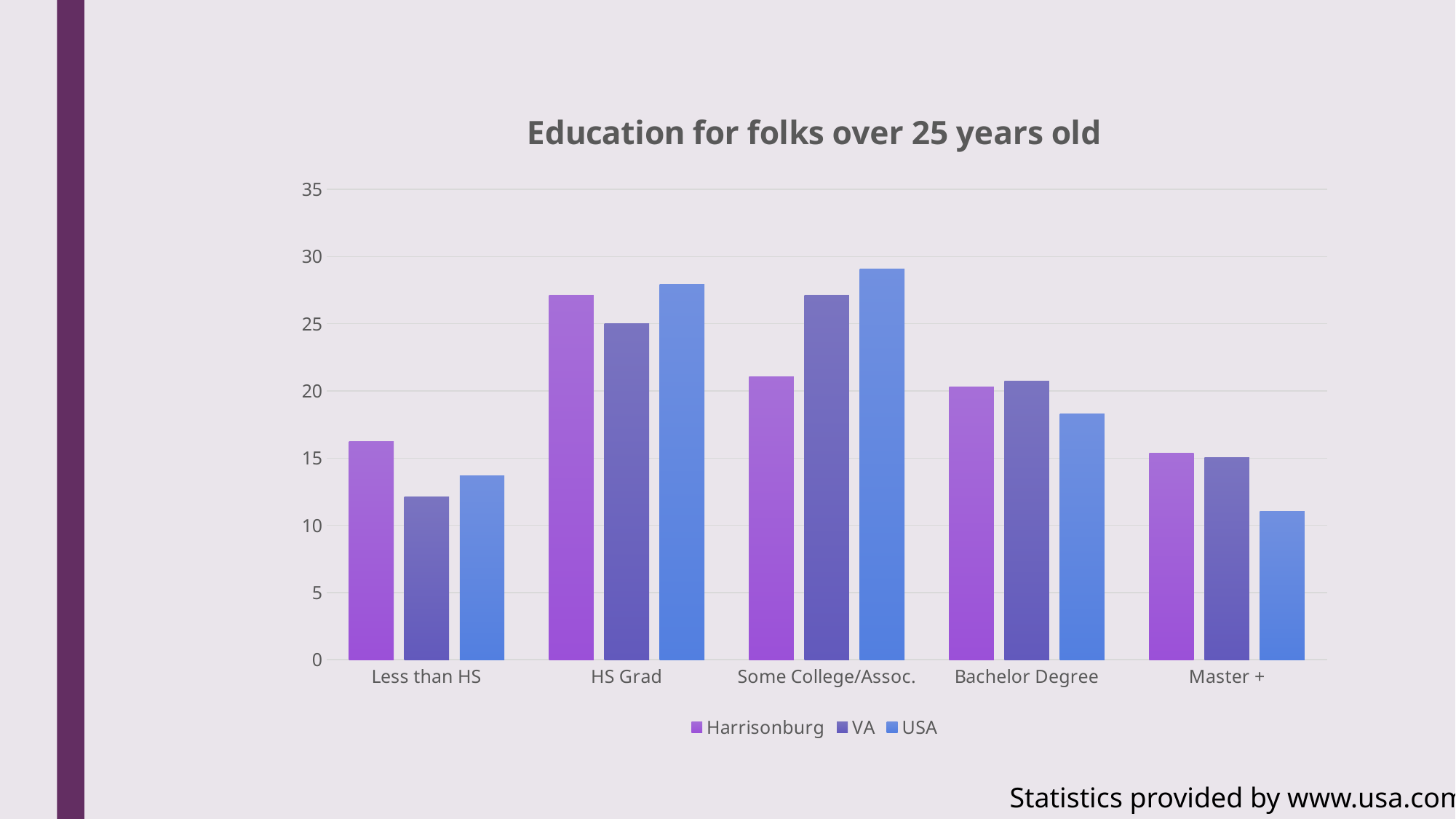
Is the value for USA in the Bachelor Degree category greater or less than 20? less What is the title of the chart? Education for folks over 25 years old In the Less than HS category, which is larger: Harrisonburg or USA? Harrisonburg How many series does the legend list? 3 How many education categories are shown on the x axis? 5 In the Some College/Assoc. category, which is larger: Harrisonburg or VA? VA What type of chart is shown on the slide? bar chart Which category has the highest value for Harrisonburg? HS Grad Which category has the lowest value for VA? Less than HS Is the value for USA in the Some College/Assoc. category greater or less than 25? greater Is the value for Harrisonburg in the Less than HS category greater or less than 15? greater Which category has the lowest value for USA? Master +